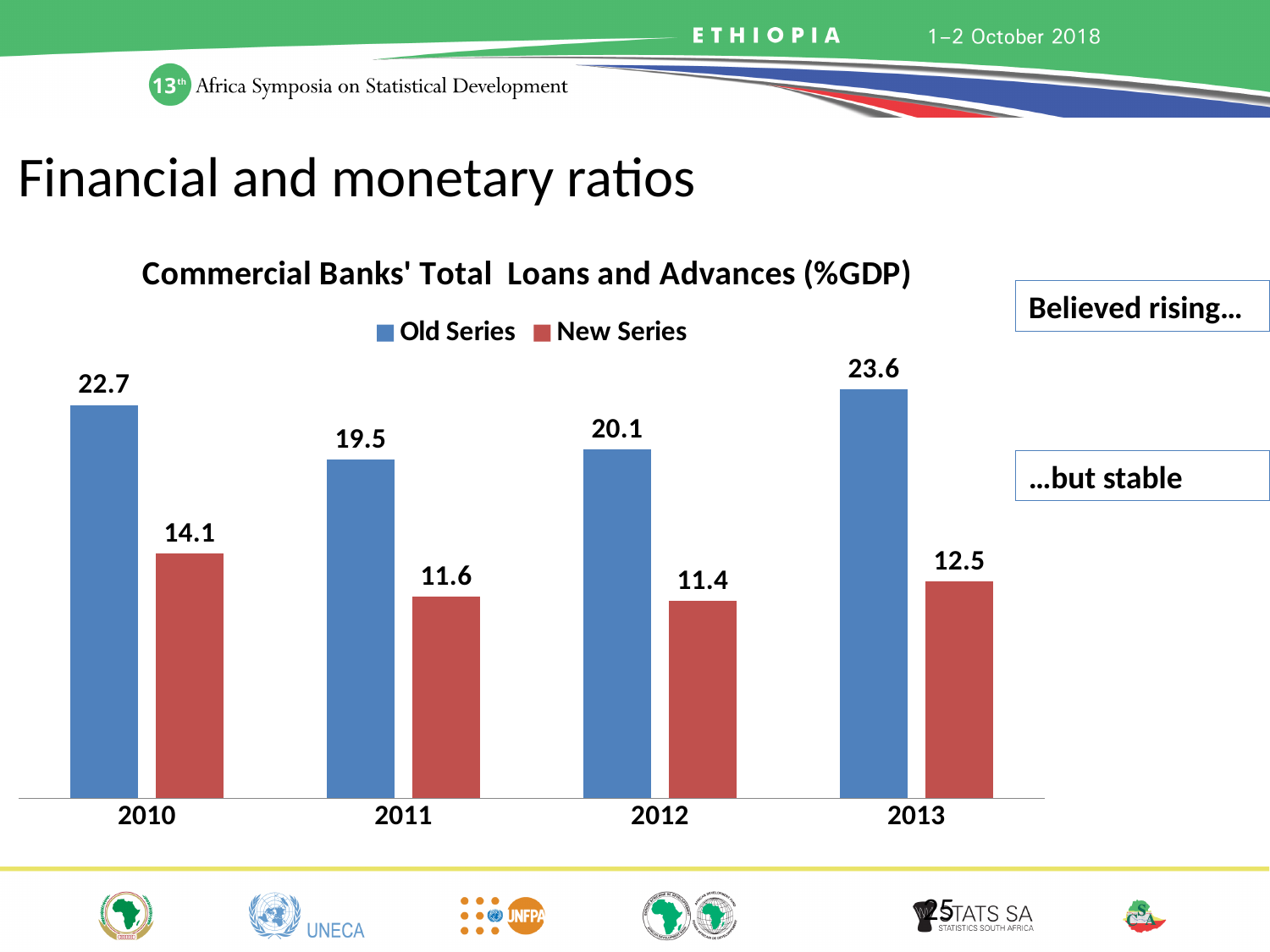
What is the Old Series value for 2010? 22.7 What is the New Series value for 2012? 11.4 Which is larger, the New Series value for 2010 or for 2013? 2010 What is the New Series value for 2013? 12.5 How many years are shown on the x axis? 4 Which colour represents the New Series in the chart? Red What kind of chart is shown on the slide? Bar chart Which year has the lowest New Series value? 2012 What is the title of the chart? Commercial Banks' Total Loans and Advances (%GDP) How many series does the legend list? 2 What is the difference between the Old Series and New Series values in 2011? 7.9 Which year has the highest Old Series value? 2013